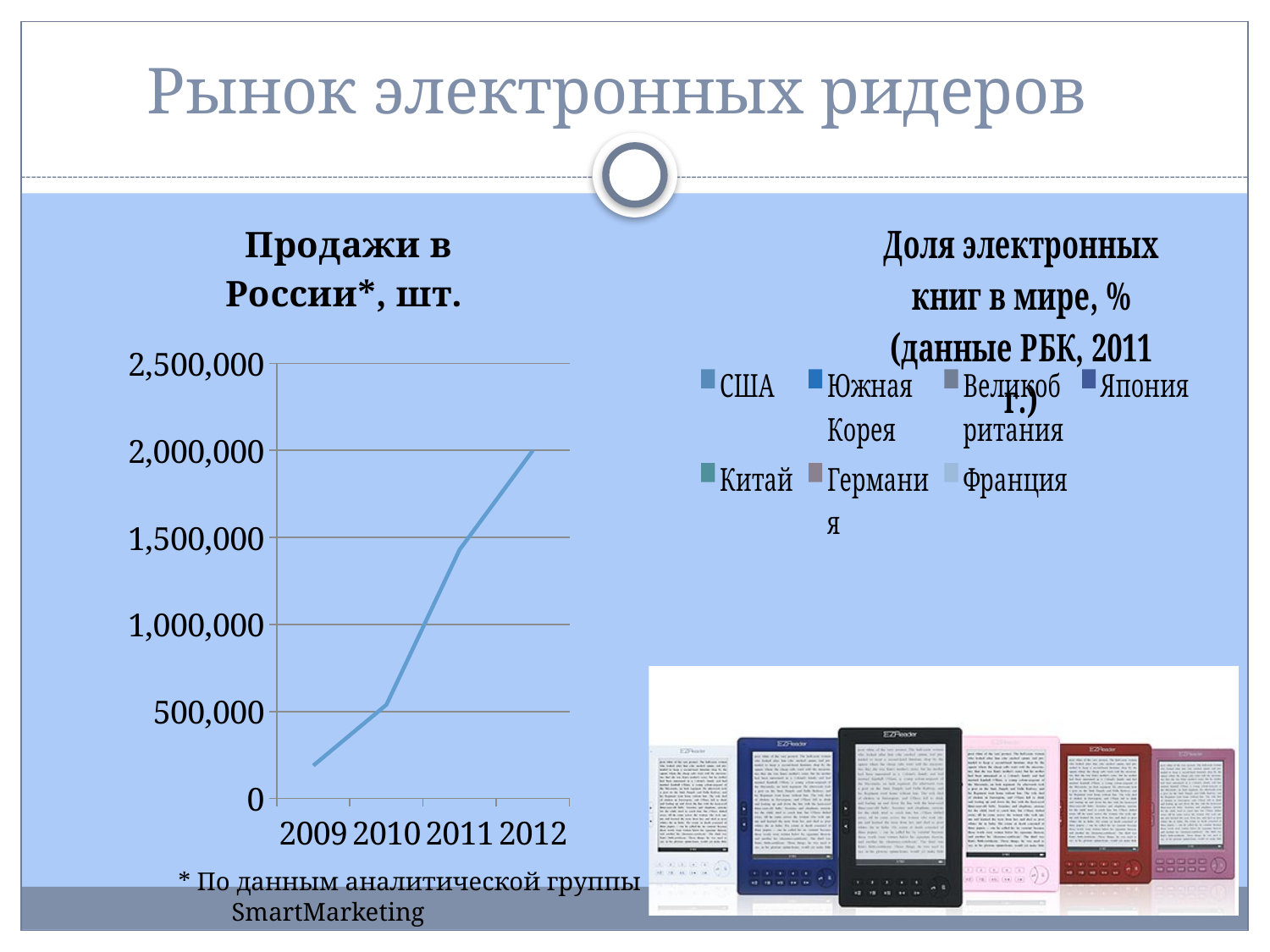
How many years are plotted on the x axis of the 'Продажи в России*, шт.' chart? 4 In the 'Продажи в России*, шт.' chart, is the value for 2011 greater or less than 1,000,000? greater In the 'Продажи в России*, шт.' chart, is the value for 2009 greater or less than 500,000? less How many entries does the legend of the 'Доля электронных книг в мире, %' chart list? 7 In the 'Продажи в России*, шт.' chart, which year has the larger value, 2010 or 2011? 2011 In the 'Продажи в России*, шт.' chart, is the value for 2012 greater or less than 1,500,000? greater In the 'Продажи в России*, шт.' chart, which year has the lowest value? 2009 What is the first entry in the legend of the 'Доля электронных книг в мире, %' chart? США What kind of chart is the 'Продажи в России*, шт.' chart? line chart In the 'Продажи в России*, шт.' chart, which year has the highest value? 2012 In the 'Продажи в России*, шт.' chart, do sales rise or fall from 2009 to 2012? rise